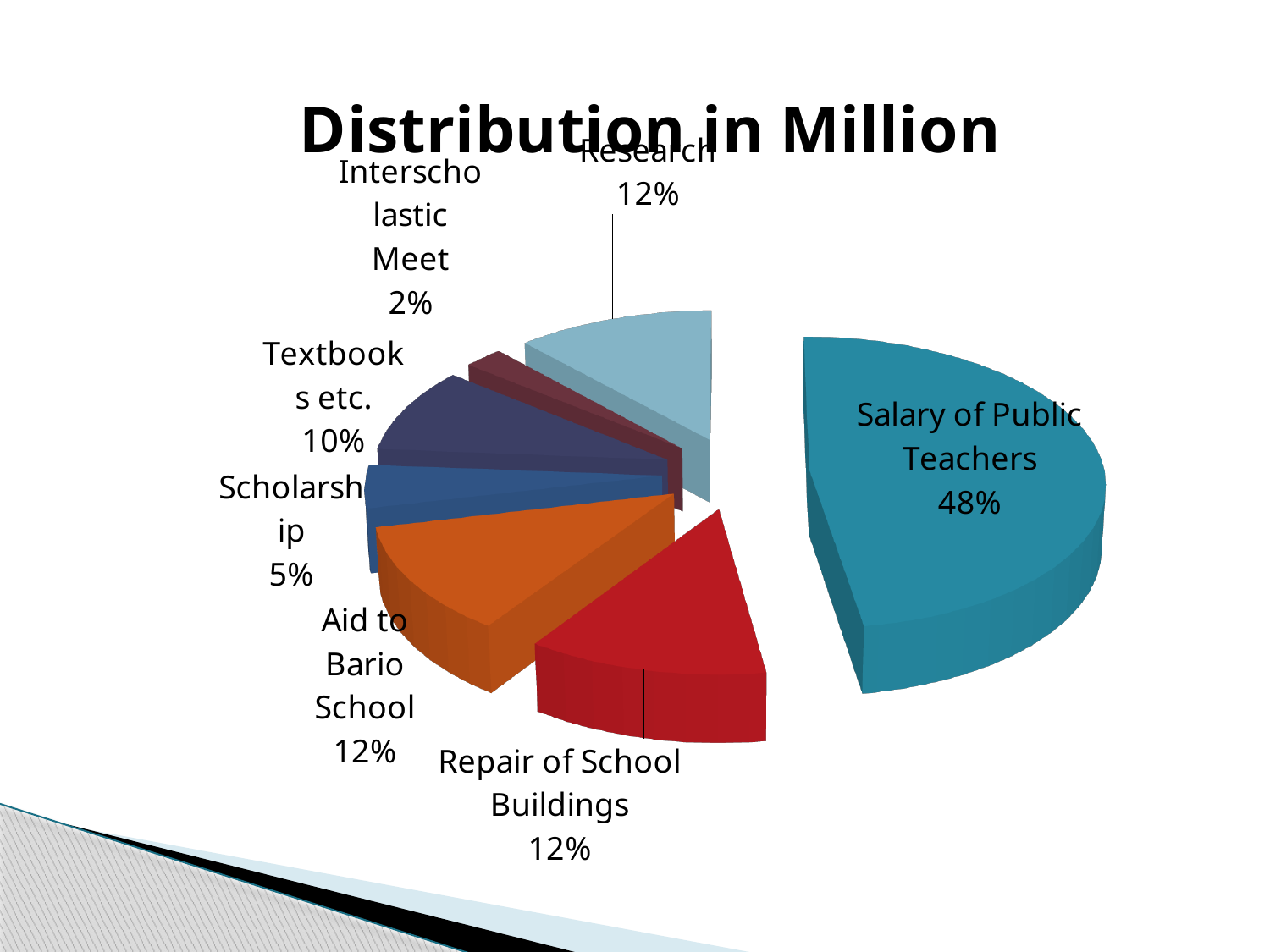
What is the title of the chart? Distribution in Million What share of the pie is Interscholastic Meet? 2% What kind of chart is shown on the slide? Pie chart Which category has the largest slice of the pie? Salary of Public Teachers What is the difference in percentage points between Salary of Public Teachers and Research? 36 Which category has the smallest slice of the pie? Interscholastic Meet What share of the pie is Salary of Public Teachers? 48% How many slices does the pie chart have? 7 What share of the pie is Textbooks etc.? 10% Which is larger, the share for Textbooks etc. or the share for Scholarship? Textbooks etc.